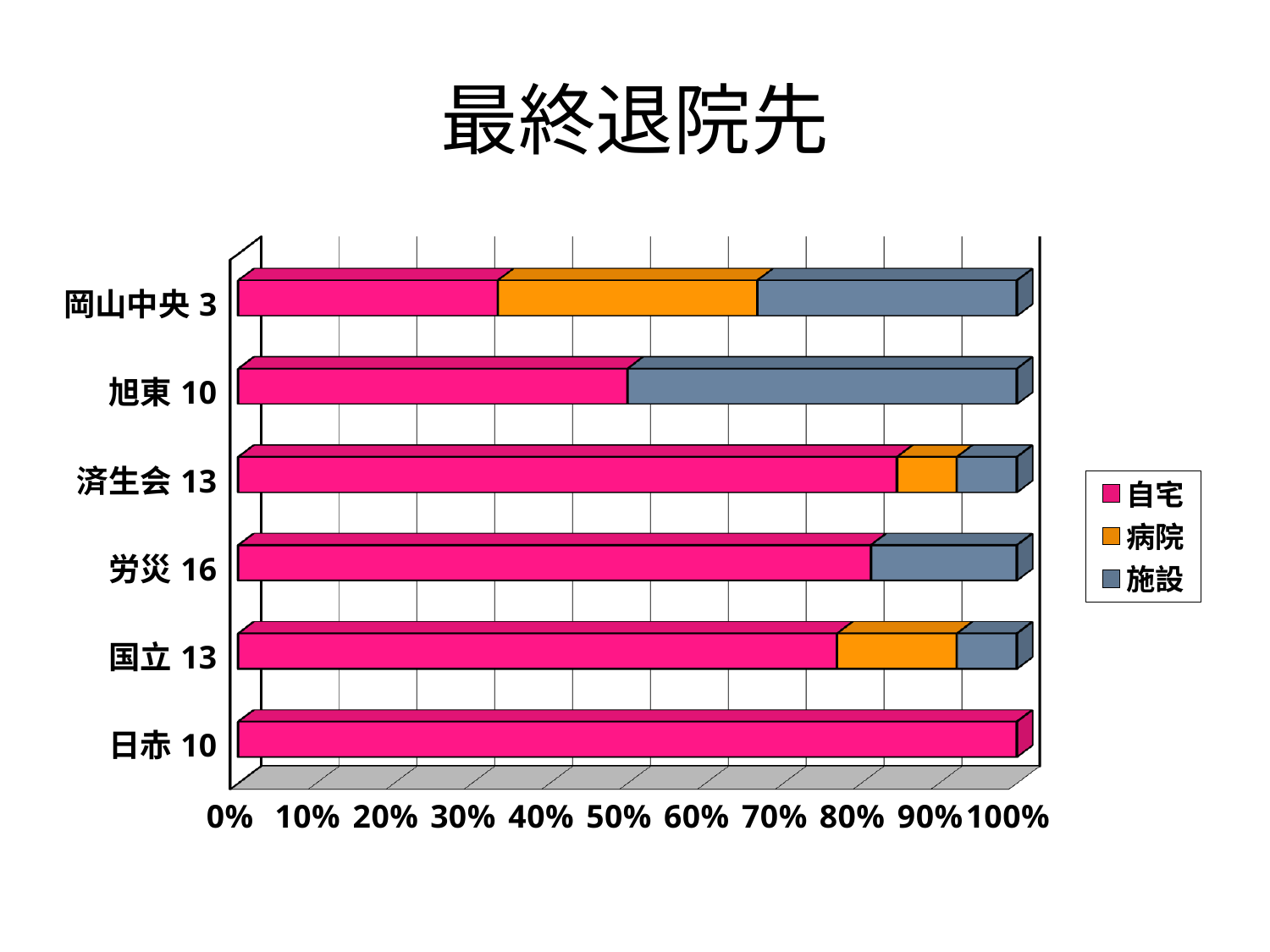
Which hospital has the lowest 自宅 share? 岡山中央 3 Which hospital has the highest 自宅 share? 日赤 10 Is the 自宅 share for 岡山中央 3 greater or less than 40%? less Is the 自宅 share for 済生会 13 greater or less than 80%? greater Is the 自宅 share for 国立 13 greater or less than 70%? greater How many hospitals (categories) are shown on the chart? 6 Which has the larger 自宅 share, 岡山中央 3 or 労災 16? 労災 16 Which series is shown in orange in the legend? 病院 How many series does the legend list? 3 What is the title of the chart? 最終退院先 What kind of chart is shown on the slide? Stacked bar chart What is the 自宅 share for 日赤 10? 100%